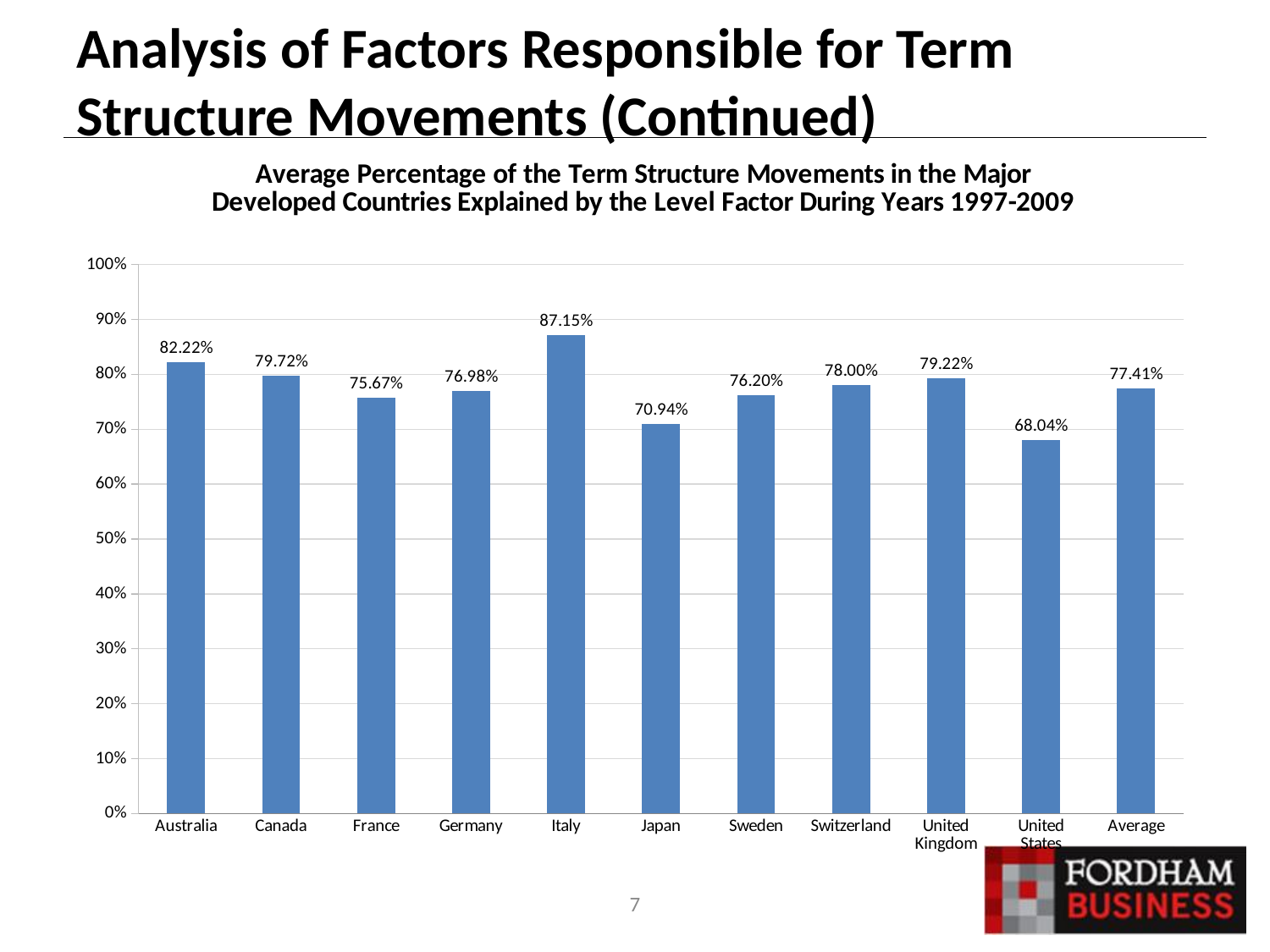
How many categories are shown on the x axis? 11 What is the title of the chart? Average Percentage of the Term Structure Movements in the Major Developed Countries Explained by the Level Factor During Years 1997-2009 Which category has the highest value? Italy What is the difference between the values for Italy and United States? 19.11% Is the value for Japan greater or less than 80%? less What is the value shown for Average? 77.41% Which category has the lowest value? United States What is the value for Italy? 87.15% What is the difference between the values for United Kingdom and Switzerland? 1.22% What is the value for Japan? 70.94% Which is larger, the value for Australia or the value for Canada? Australia What kind of chart is this? bar chart